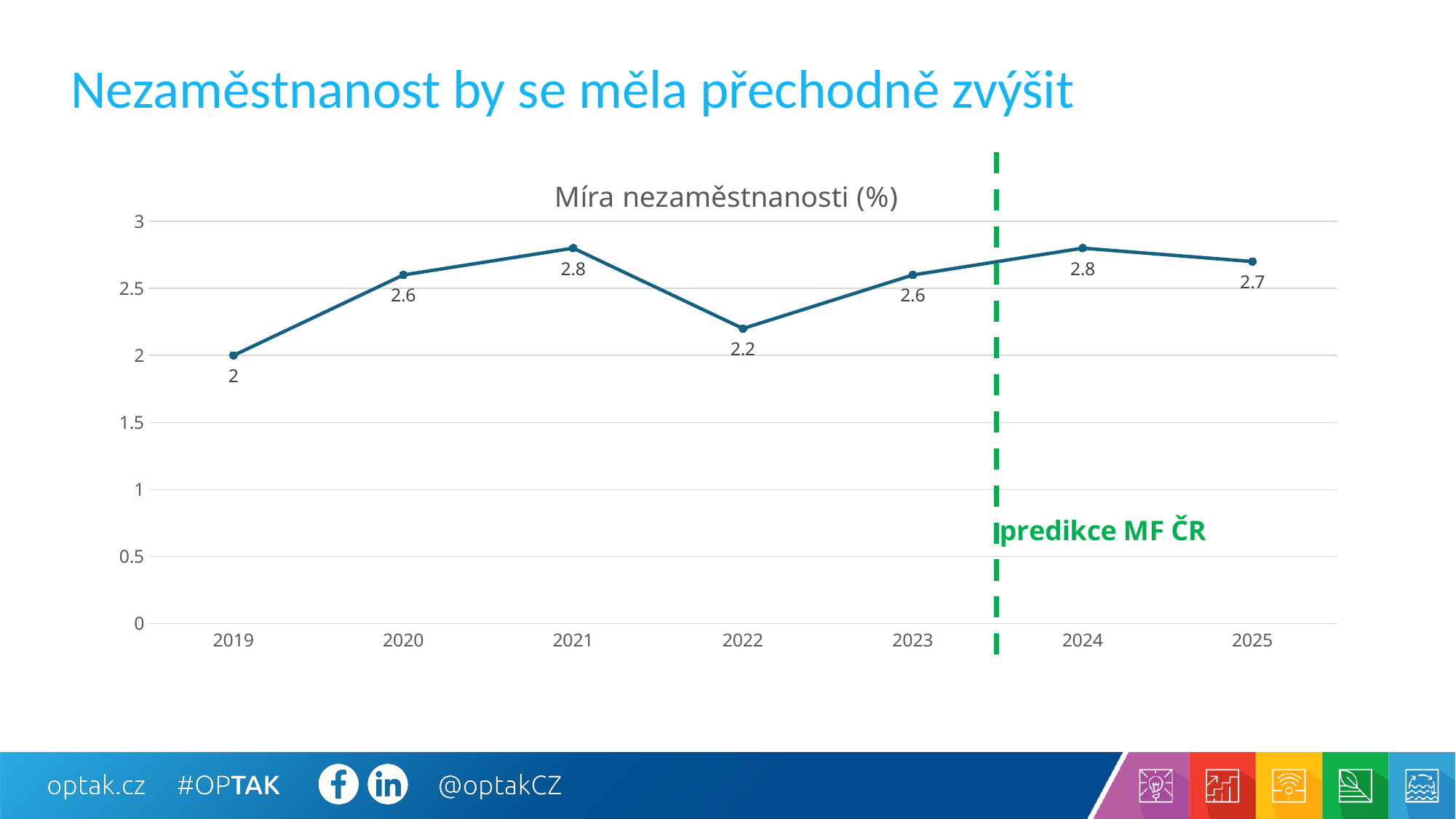
What is the difference between the values for 2021 and 2022? 0.6 Is the value for 2021 greater or less than 2.5? greater Which is larger, the value for 2023 or the value for 2024? 2024 What is the title of the chart? Míra nezaměstnanosti (%) What kind of chart is shown on the slide? line chart What is the unemployment rate value for 2022? 2.2 What is the difference between the values for 2019 and 2020? 0.6 Which year has the lowest unemployment rate on the chart? 2019 How many years are plotted on the chart? 7 Does the unemployment rate rise or fall from 2022 to 2024? rise What is the unemployment rate value for 2025? 2.7 What is the unemployment rate value for 2019? 2